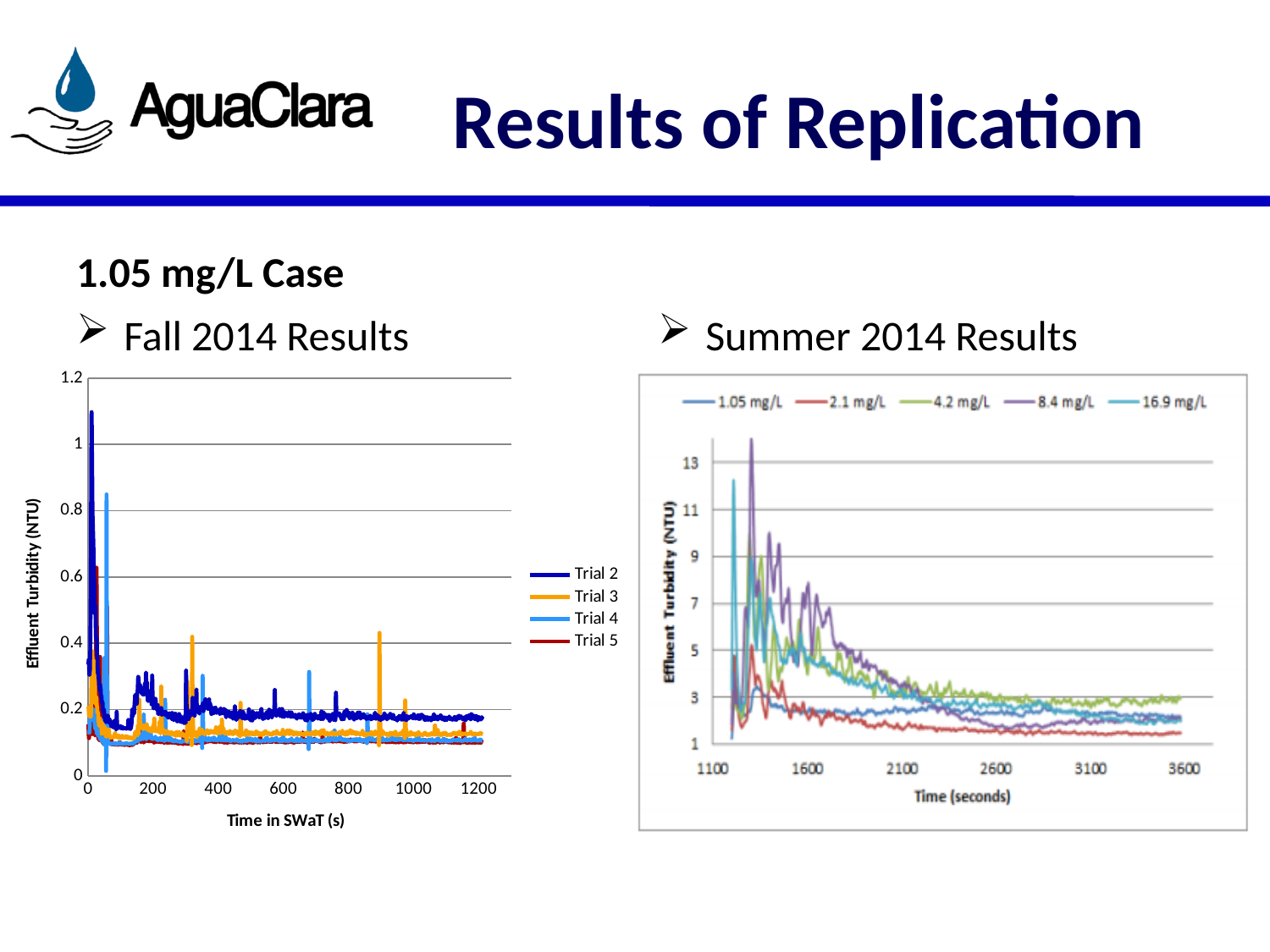
In the Summer 2014 Results chart, which series reaches the highest peak turbidity? 8.4 mg/L In the Fall 2014 Results chart, which trial reaches the highest peak turbidity? Trial 2 What is the y-axis title of the Summer 2014 Results chart? Effluent Turbidity (NTU) How many series does the legend of the Summer 2014 Results chart list? 5 In the Summer 2014 Results chart, do the turbidity values generally rise or fall as time increases? fall In the Summer 2014 Results chart, is the peak value for the 16.9 mg/L series greater or less than 11? greater What is the x-axis title of the Fall 2014 Results chart? Time in SWaT (s) In the Fall 2014 Results chart, is the peak value for Trial 4 greater or less than 0.8? greater What type of chart is the Fall 2014 Results chart? line chart In the Fall 2014 Results chart, is the peak value for Trial 2 greater or less than 1? greater In the Fall 2014 Results chart, which is higher at 1200 s, Trial 2 or Trial 5? Trial 2 How many series does the legend of the Fall 2014 Results chart list? 4